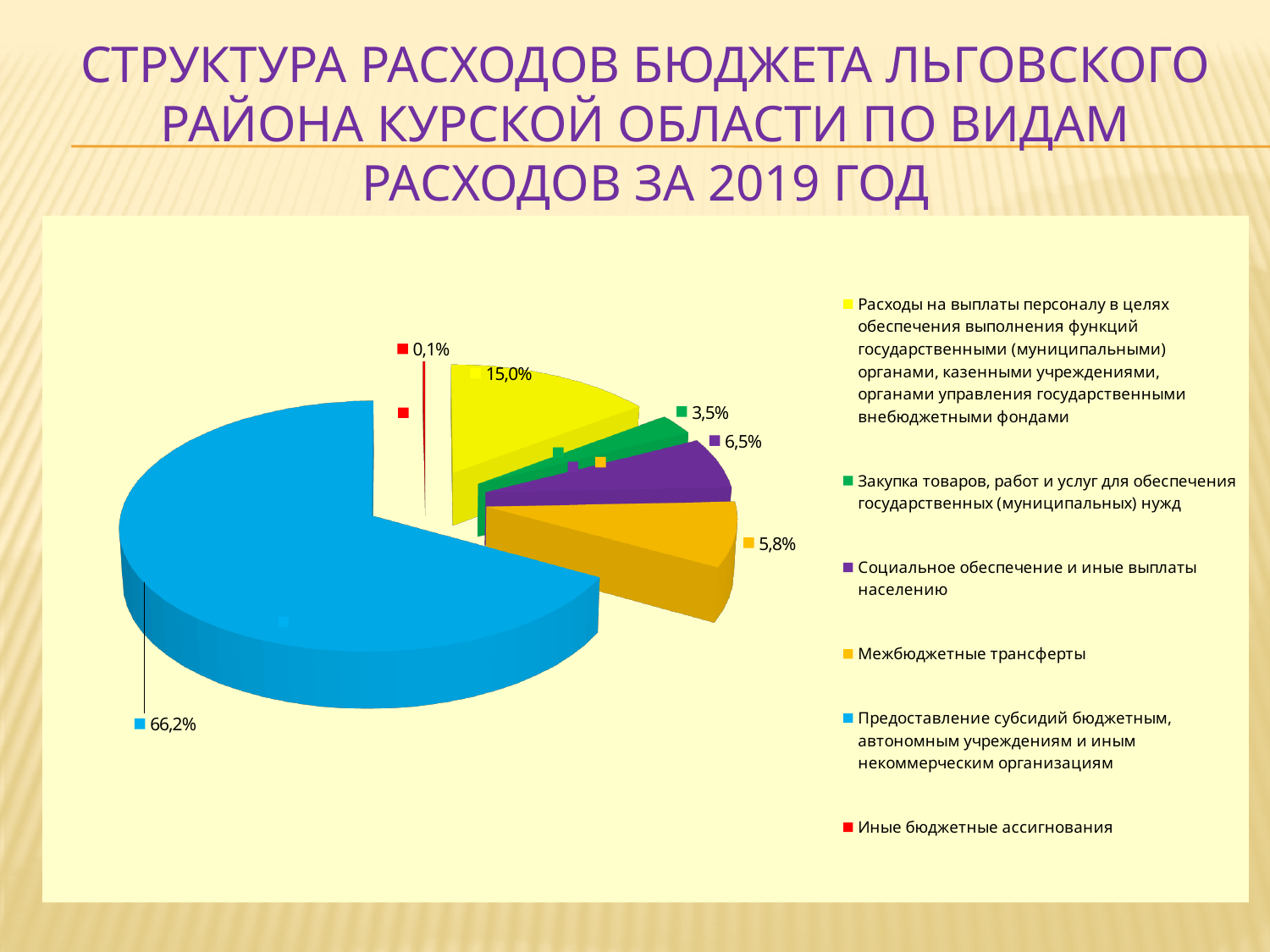
What share of the pie does the slice for "Предоставление субсидий бюджетным, автономным учреждениям и иным некоммерческим организациям" have? 66,2% Which category has the largest slice of the pie? Предоставление субсидий бюджетным, автономным учреждениям и иным некоммерческим организациям What percentage is labelled for "Межбюджетные трансферты"? 5,8% Which is larger: the slice for "Межбюджетные трансферты" or the slice for "Закупка товаров, работ и услуг для обеспечения государственных (муниципальных) нужд"? Межбюджетные трансферты What is the value shown for "Расходы на выплаты персоналу в целях обеспечения выполнения функций государственными (муниципальными) органами, казенными учреждениями, органами управления государственными внебюджетными фондами"? 15,0% How many slices does the pie chart have? 6 What type of chart is shown on the slide? Pie chart Which category has the smallest slice of the pie? Иные бюджетные ассигнования What is the value for "Иные бюджетные ассигнования"? 0,1% What is the difference between the values for "Социальное обеспечение и иные выплаты населению" and "Закупка товаров, работ и услуг для обеспечения государственных (муниципальных) нужд"? 3,0% What is the value for "Социальное обеспечение и иные выплаты населению"? 6,5% What colour is the slice for "Закупка товаров, работ и услуг для обеспечения государственных (муниципальных) нужд"? Green